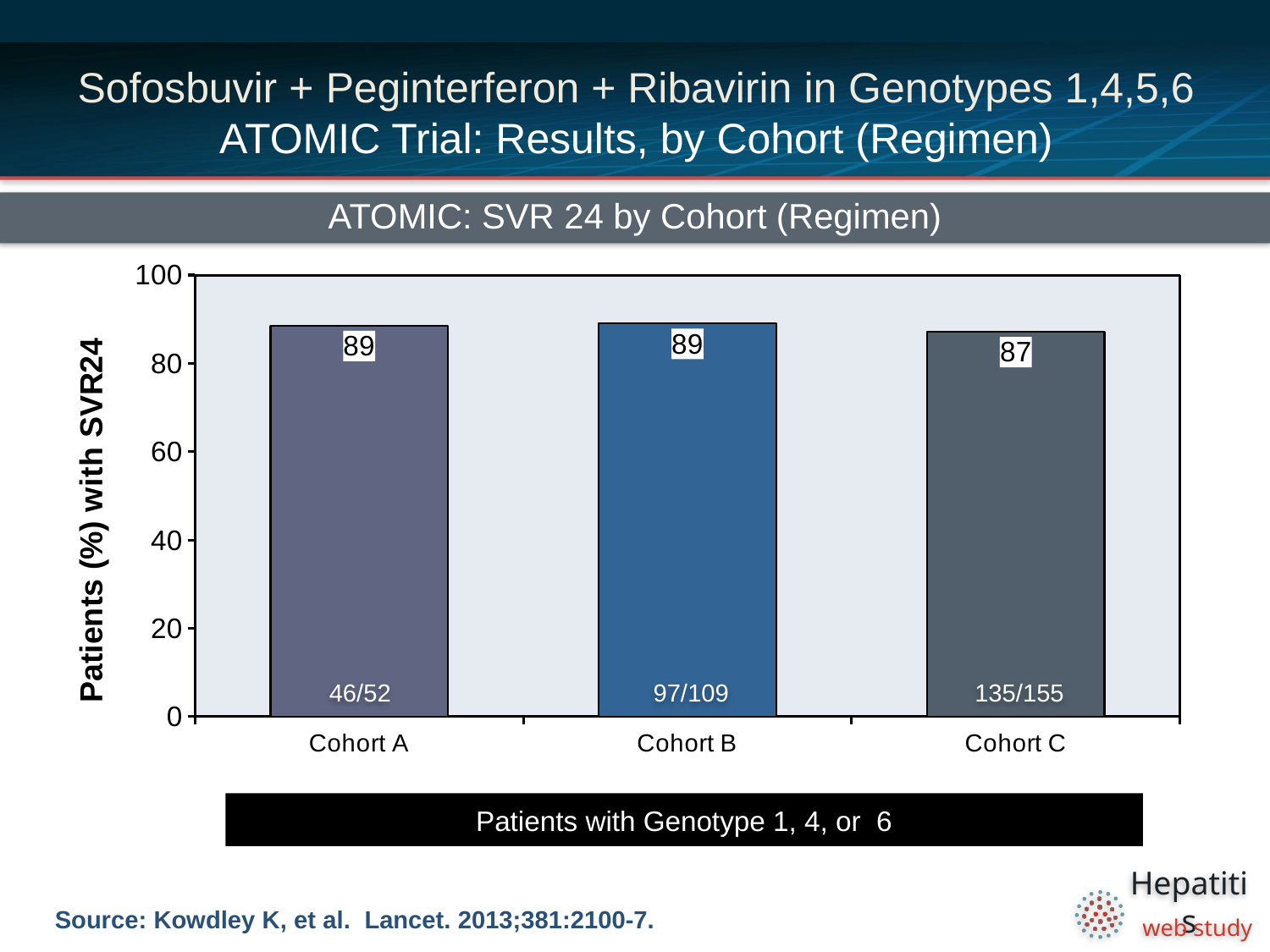
What fraction of patients is printed on the bar for Cohort C? 135/155 What kind of chart is shown on the slide? Bar chart What is the label of the y axis? Patients (%) with SVR24 What is the title of the chart? ATOMIC: SVR 24 by Cohort (Regimen) Which cohort has the lowest percentage of patients with SVR24? Cohort C What is the value for Cohort B? 89 Is the value for Cohort B greater or less than 80? greater What is the value for Cohort A? 89 What fraction of patients is printed on the bar for Cohort B? 97/109 What is the difference between the values for Cohort A and Cohort C? 2 What is the value for Cohort C? 87 How many cohorts are shown in the chart? 3